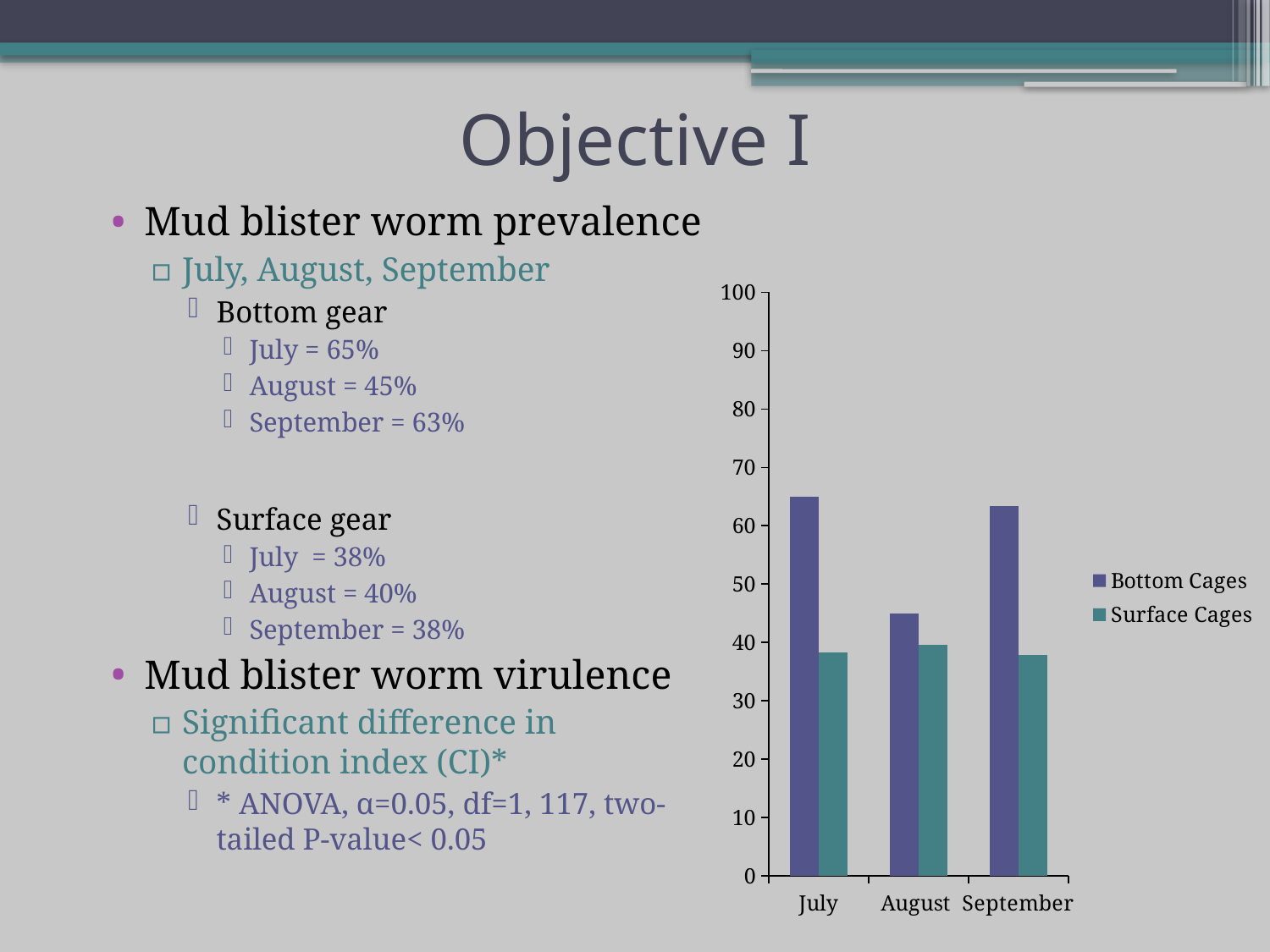
Is the Bottom Cages value for September greater or less than 60? greater How many series does the chart legend list? 2 Is the Surface Cages value for July greater or less than 30? greater Is the Bottom Cages value for August greater or less than 50? less Which month has the highest Bottom Cages bar? July What kind of chart is shown on the slide? bar chart In July, which is larger: Bottom Cages or Surface Cages? Bottom Cages How many months are shown on the x axis of the chart? 3 What are the two entries in the chart legend? Bottom Cages, Surface Cages Which month has the lowest Bottom Cages bar? August According to the slide, what is the mud blister worm prevalence for bottom gear in July? 65% According to the slide, what is the mud blister worm prevalence for surface gear in August? 40%